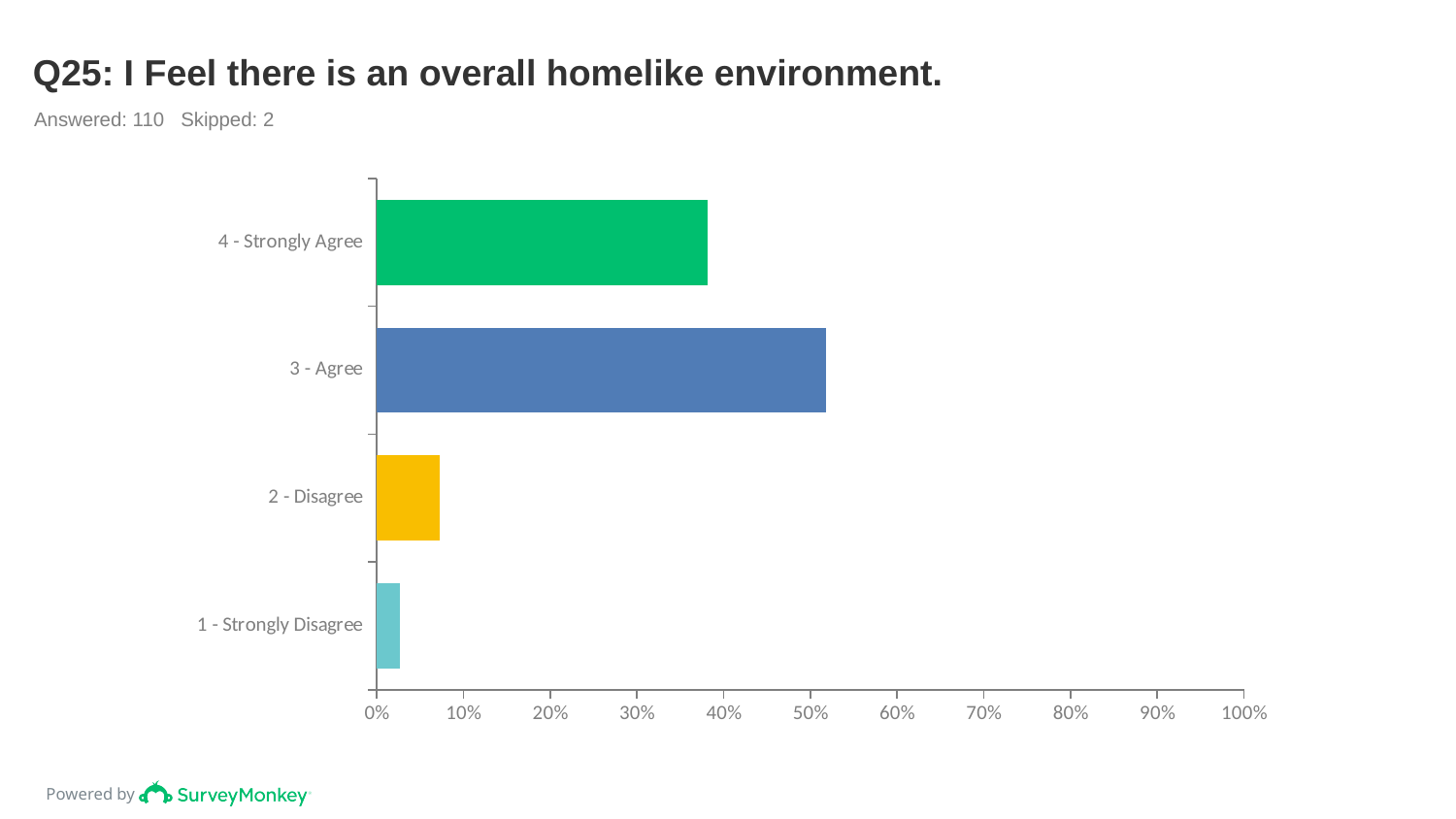
Is the value for 4 - Strongly Agree greater or less than 40%? less Which category has the highest value? 3 - Agree How many categories are plotted in the chart? 4 Which is larger, the value for 4 - Strongly Agree or the value for 3 - Agree? 3 - Agree What is the title of the chart? Q25: I Feel there is an overall homelike environment. How many respondents answered the question according to the slide? 110 Is the value for 4 - Strongly Agree greater or less than 30%? greater Which category has the lowest value? 1 - Strongly Disagree What kind of chart is shown on the slide? bar chart Which is larger, the value for 2 - Disagree or the value for 1 - Strongly Disagree? 2 - Disagree Is the value for 2 - Disagree greater or less than 10%? less